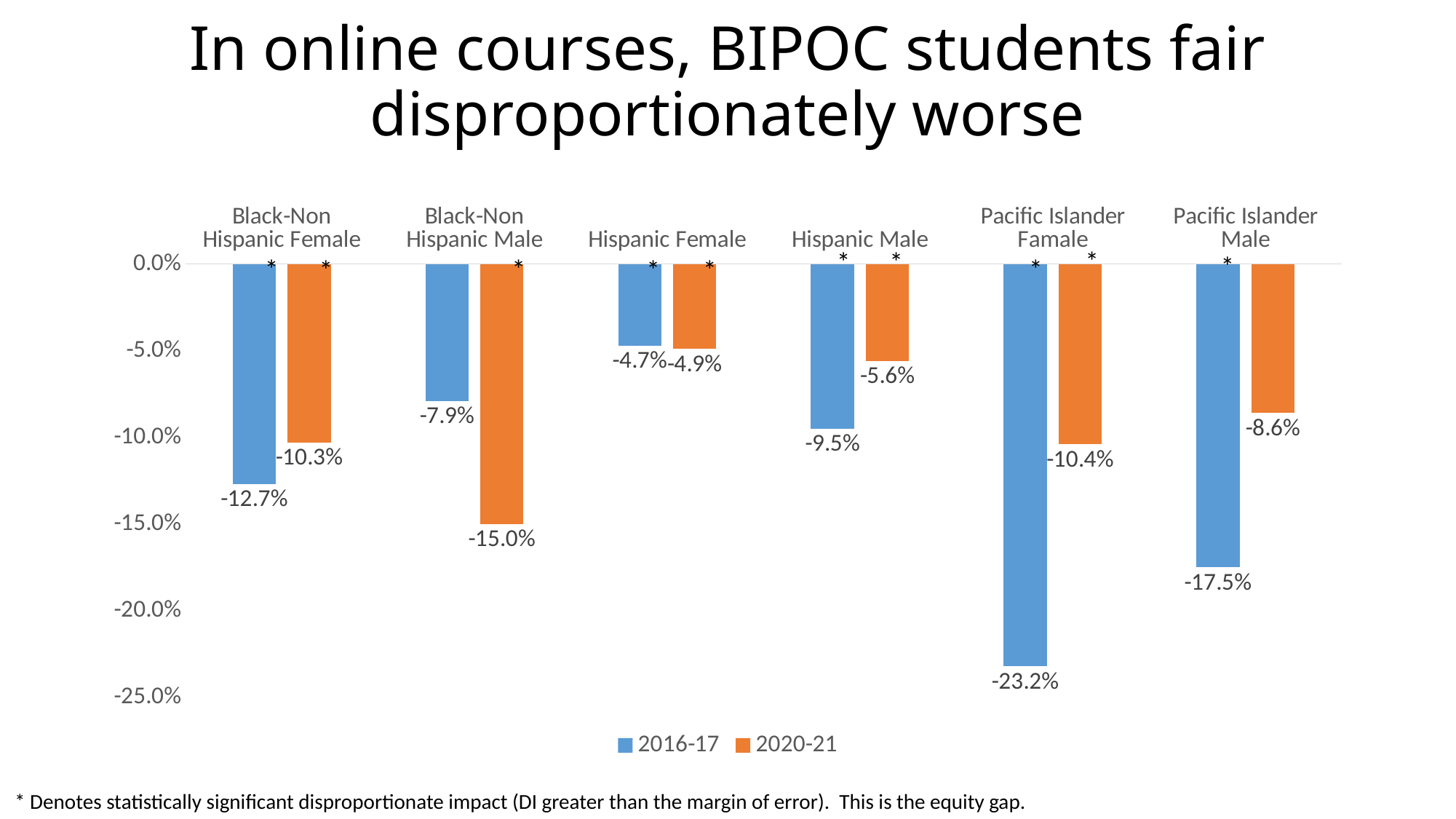
What is the difference in percentage points between the 2016-17 and 2020-21 values for Pacific Islander Famale? 12.8 percentage points What is the 2020-21 value for Hispanic Male? -5.6% How many categories are shown on the x axis? 6 What is the 2016-17 value for Black-Non Hispanic Female? -12.7% Which category has the most negative 2016-17 value? Pacific Islander Famale How many series does the legend list? 2 What is the 2016-17 value for Pacific Islander Male? -17.5% What is the 2020-21 value for Black-Non Hispanic Male? -15.0% Which colour represents the 2020-21 series? Orange Which is more negative for Black-Non Hispanic Male: the 2016-17 value or the 2020-21 value? 2020-21 Which category has the 2020-21 value closest to zero? Hispanic Female What type of chart is shown on the slide? Bar chart